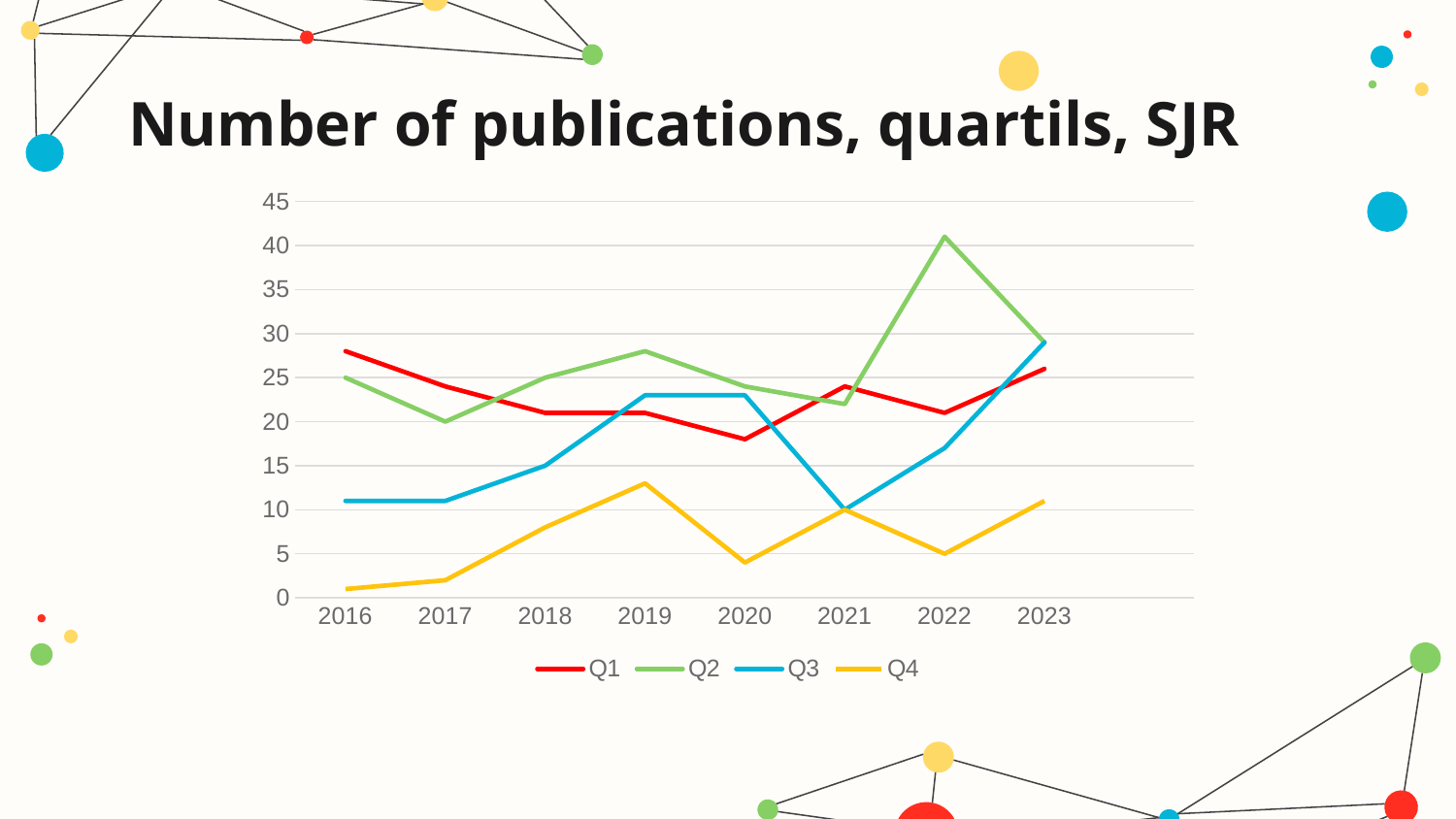
Is the value for Q3 in 2023 greater or less than 25? greater What kind of chart is shown on the slide? line chart In which year does the Q2 series reach its highest value? 2022 How many series does the legend list? 4 What is the title of the slide? Number of publications, quartils, SJR What colour is the Q3 line in the legend? blue In which year does the Q4 series have its lowest value? 2016 In 2016, which series has the larger value, Q1 or Q3? Q1 How many years are shown on the x axis? 8 Is the value for Q4 in 2016 greater or less than 5? less Is the value for Q2 in 2022 greater or less than 35? greater Does the Q4 series rise or fall from 2016 to 2019? rise